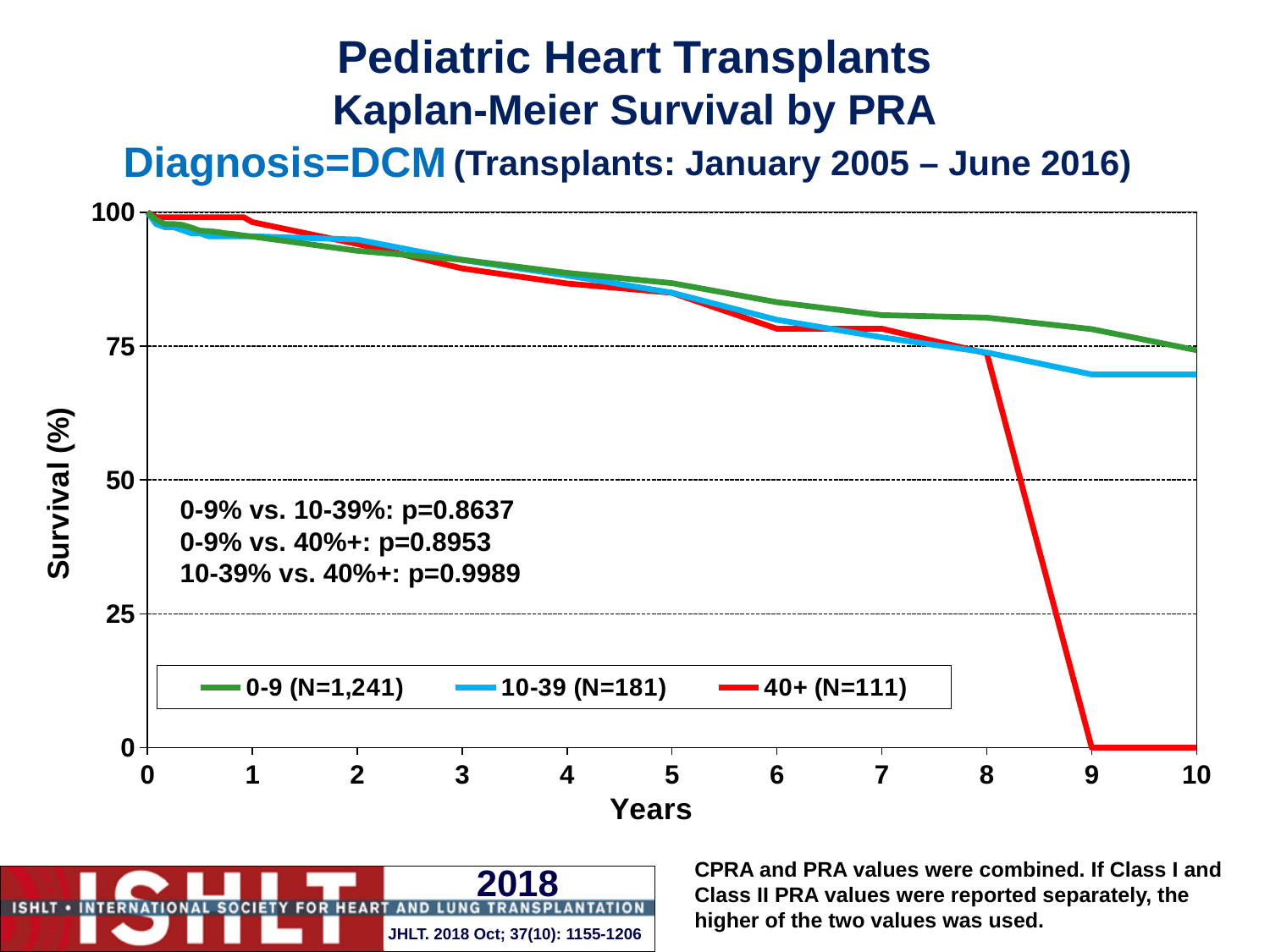
Is the survival for the 0-9 group at year 10 greater or less than 50? greater At year 10, which group has higher survival, 0-9 or 10-39? 0-9 What kind of chart is shown on the slide? Line chart What is the maximum value shown on the Survival (%) axis? 100 Is the survival for the 10-39 group at year 10 greater or less than 75? less What is the N for the 0-9 group in the legend? 1,241 Do the survival curves rise or fall as years increase? fall Is the survival for the 40+ group at year 8 greater or less than 50? greater What is the survival value for the 40+ group at year 10? 0 Which PRA group has the lowest survival at year 10? 40+ (N=111) How many series does the legend list? 3 What is the p-value for the comparison of 0-9% vs. 10-39%? p=0.8637